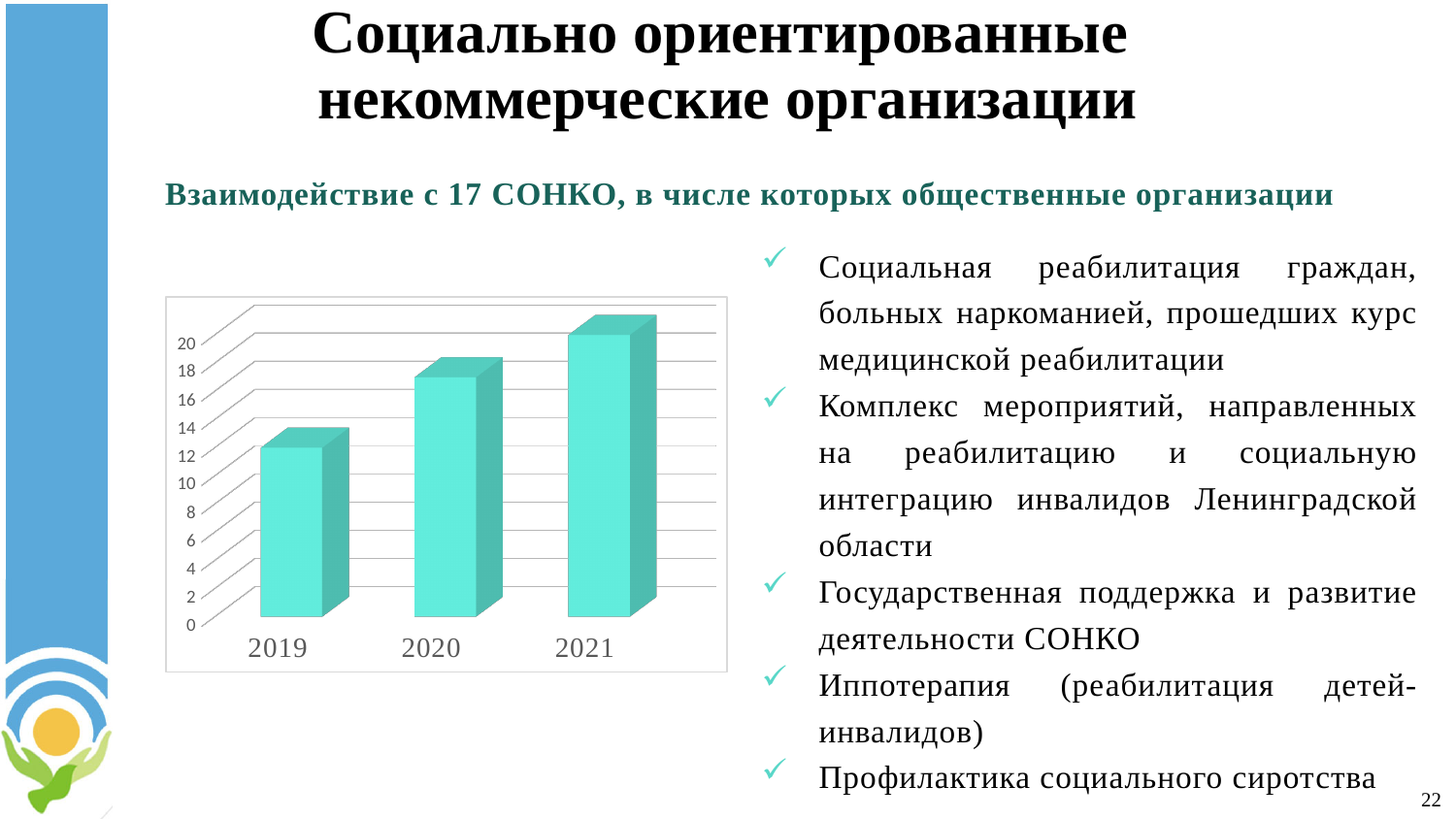
What is the highest tick value shown on the vertical axis of the chart? 20 Which is larger, the value for 2019 or the value for 2021? 2021 Which year has the highest bar in the chart? 2021 Which is larger, the value for 2020 or the value for 2019? 2020 Do the values rise or fall from 2019 to 2021? rise Is the value for 2019 greater or less than 14? less Which year has the lowest bar in the chart? 2019 Is the value for 2019 greater or less than 10? greater How many categories (years) are shown on the x axis of the chart? 3 Is the value for 2021 greater or less than 18? greater What kind of chart is shown on the slide? bar chart